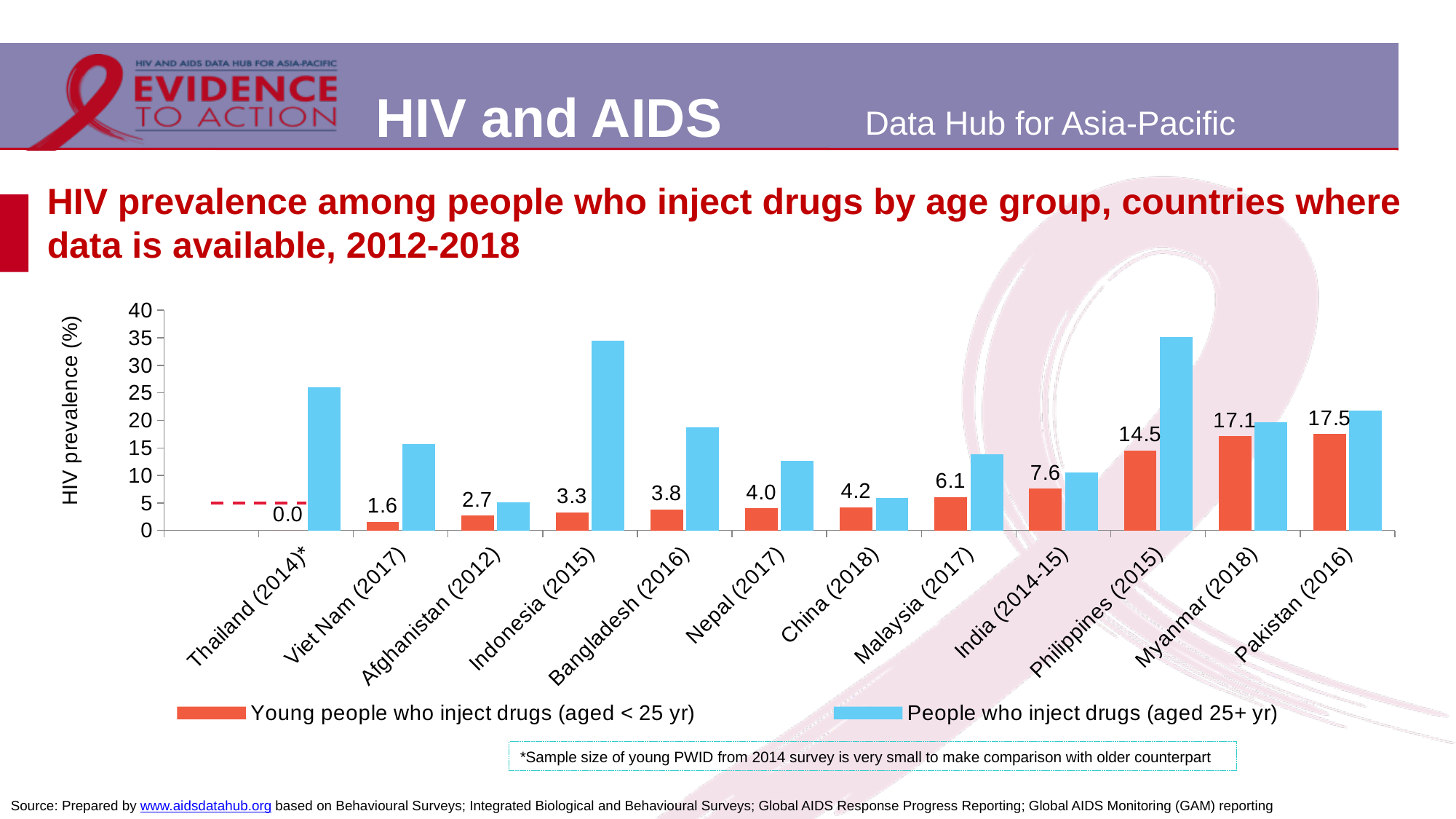
What is the difference in HIV prevalence among young people who inject drugs between Philippines (2015) and India (2014-15)? 6.9 What is the HIV prevalence among young people who inject drugs (aged < 25 yr) in Nepal (2017)? 4.0 Which country has the lowest HIV prevalence among young people who inject drugs (aged < 25 yr)? Thailand (2014)* How many countries are shown on the x axis of the chart? 12 Is the HIV prevalence among people who inject drugs (aged 25+ yr) in China (2018) greater or less than 10? less How many series does the legend list? 2 What is the HIV prevalence among young people who inject drugs (aged < 25 yr) in Philippines (2015)? 14.5 Is the HIV prevalence among people who inject drugs (aged 25+ yr) in Indonesia (2015) greater or less than 30? greater What kind of chart is shown on the slide? Bar chart What is the HIV prevalence among young people who inject drugs (aged < 25 yr) in Pakistan (2016)? 17.5 Which country has the highest HIV prevalence among young people who inject drugs (aged < 25 yr)? Pakistan (2016) Which is larger: the HIV prevalence among young people who inject drugs in Malaysia (2017) or in China (2018)? Malaysia (2017)